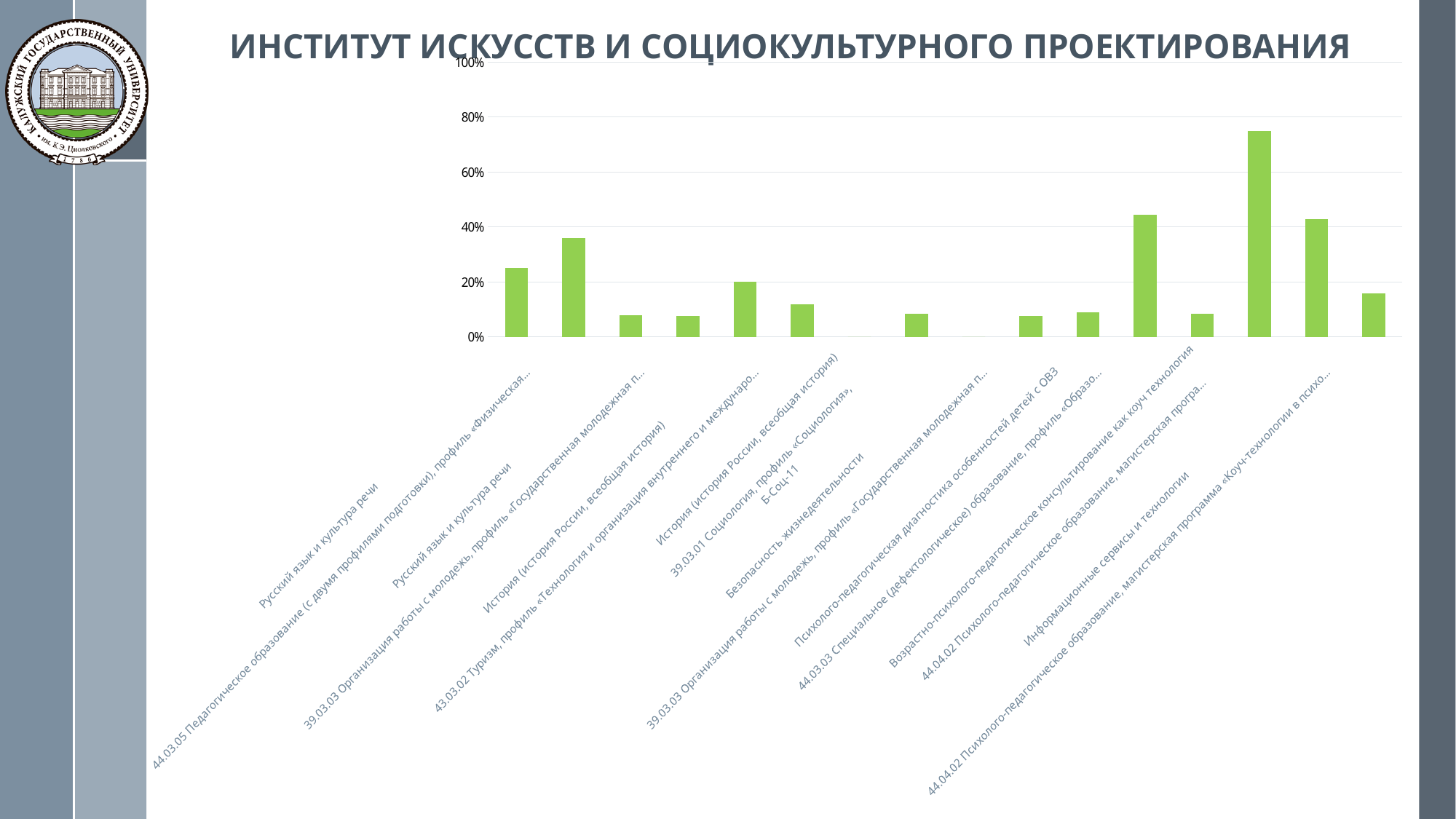
What is the highest value shown on the chart's vertical axis? 100% Is the value for Информационные сервисы и технологии greater or less than 20%? greater Is the value for Безопасность жизнедеятельности greater or less than 20%? less Is the value of the tallest bar in the chart greater or less than 80%? less Which category has the tallest bar in the chart? 44.04.02 Психолого-педагогическое образование, магистерская програ... Do the bar values rise steadily from left to right across the chart? No What kind of chart is shown on the slide? bar chart What is the title of the slide containing the chart? ИНСТИТУТ ИСКУССТВ И СОЦИОКУЛЬТУРНОГО ПРОЕКТИРОВАНИЯ